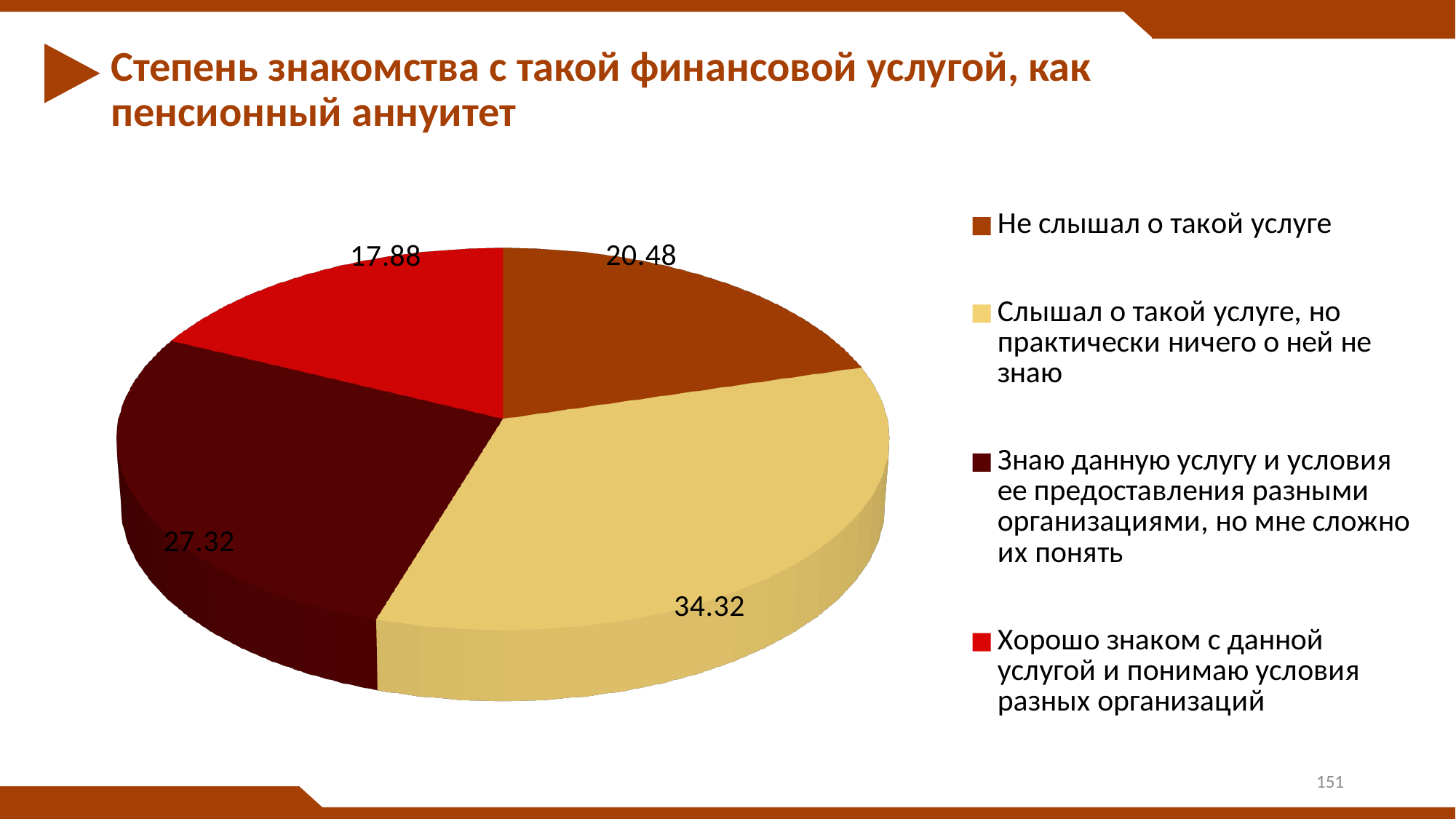
What is the value for "Хорошо знаком с данной услугой и понимаю условия разных организаций"? 17.88 What is the value for "Слышал о такой услуге, но практически ничего о ней не знаю"? 34.32 What kind of chart is shown on the slide? pie chart What colour is the slice for "Хорошо знаком с данной услугой и понимаю условия разных организаций"? red What is the value for "Знаю данную услугу и условия ее предоставления разными организациями, но мне сложно их понять"? 27.32 Which category has the smallest slice? Хорошо знаком с данной услугой и понимаю условия разных организаций What is the value for "Не слышал о такой услуге"? 20.48 What is the difference between the values for "Слышал о такой услуге, но практически ничего о ней не знаю" and "Не слышал о такой услуге"? 13.84 What is the title of the chart on the slide? Степень знакомства с такой финансовой услугой, как пенсионный аннуитет Which is larger: the value for "Не слышал о такой услуге" or the value for "Хорошо знаком с данной услугой и понимаю условия разных организаций"? Не слышал о такой услуге How many slices does the pie chart have? 4 Which category has the largest slice? Слышал о такой услуге, но практически ничего о ней не знаю